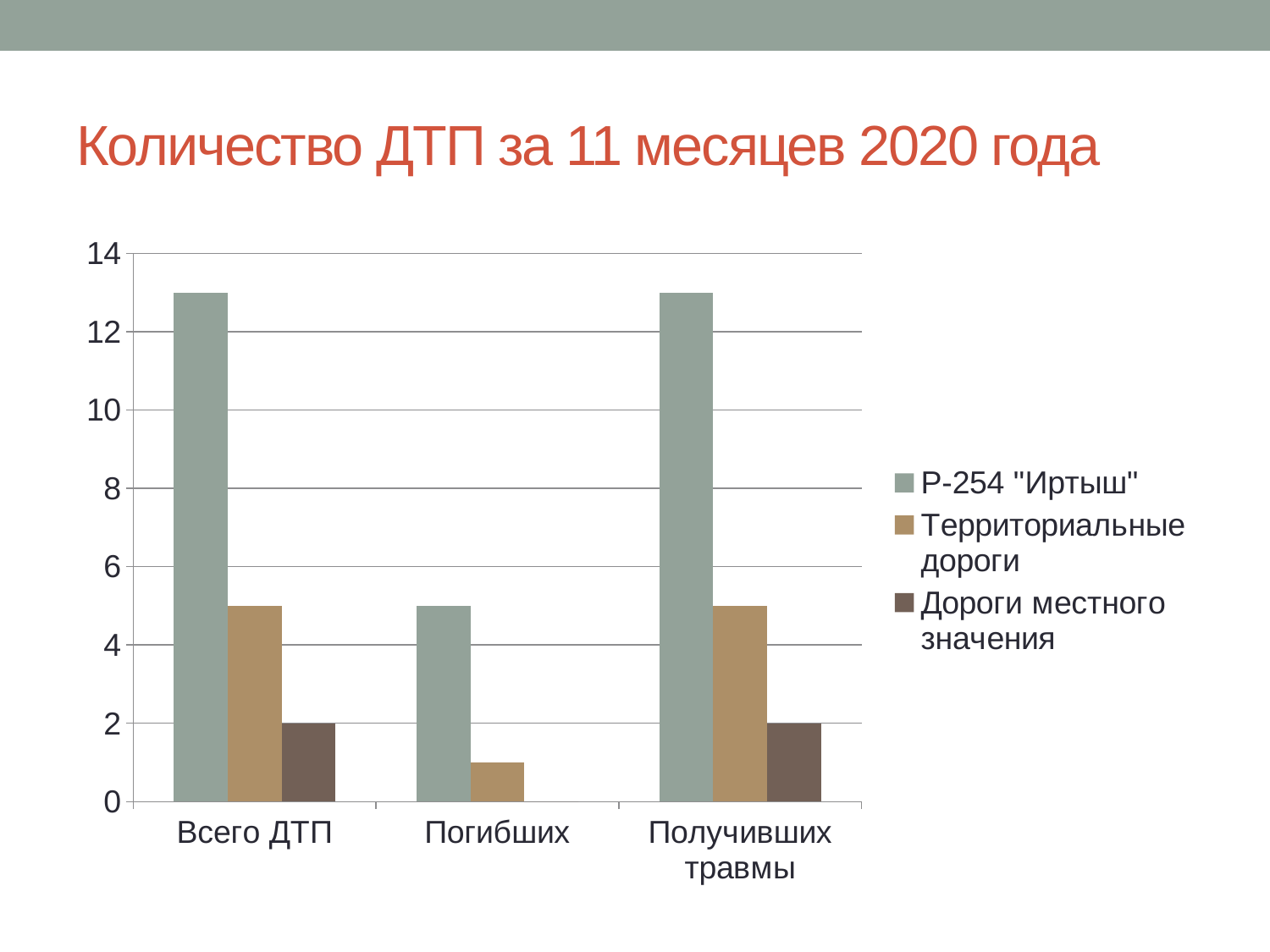
What is the value for Дороги местного значения in the Всего ДТП category? 2 What is the value for Дороги местного значения in the Получивших травмы category? 2 For Р-254 "Иртыш", which is larger: the value for Всего ДТП or the value for Погибших? Всего ДТП What kind of chart is shown on the slide? bar chart Which series has the lowest value in the Получивших травмы category? Дороги местного значения Is the value for Р-254 "Иртыш" in the Всего ДТП category greater or less than 12? greater How many categories are shown on the x axis? 3 Is the value for Р-254 "Иртыш" in the Погибших category greater or less than 4? greater Which series has the highest value in the Всего ДТП category? Р-254 "Иртыш" Is the value for Территориальные дороги in the Погибших category greater or less than 2? less What is the title of the chart? Количество ДТП за 11 месяцев 2020 года How many series does the legend list? 3